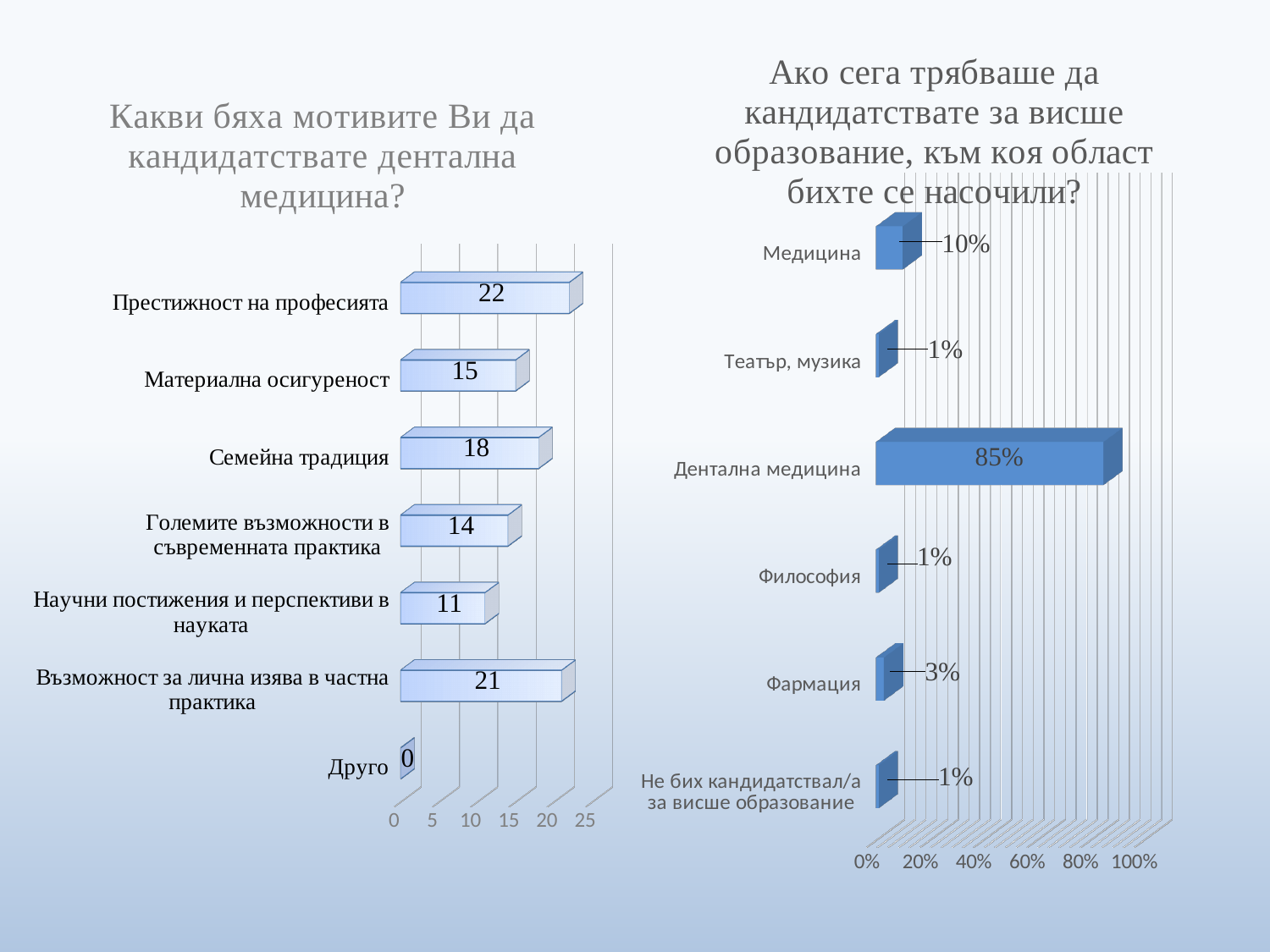
In the left chart, which is larger: Семейна традиция or Научни постижения и перспективи в науката? Семейна традиция In the right chart, which category has the highest value? Дентална медицина What kind of chart is the right chart? Bar chart In the right chart, what is the difference between Дентална медицина and Медицина? 75% In the left chart, what is the value for Престижност на професията? 22 In the right chart, what is the value for Дентална медицина? 85% In the left chart, which category has the lowest value? Друго How many categories does the left chart show? 7 In the left chart, what is the value for Семейна традиция? 18 In the right chart, what is the value for Фармация? 3% In the left chart, which category has the highest value? Престижност на професията In the left chart, what is the difference between Престижност на професията and Материална осигуреност? 7